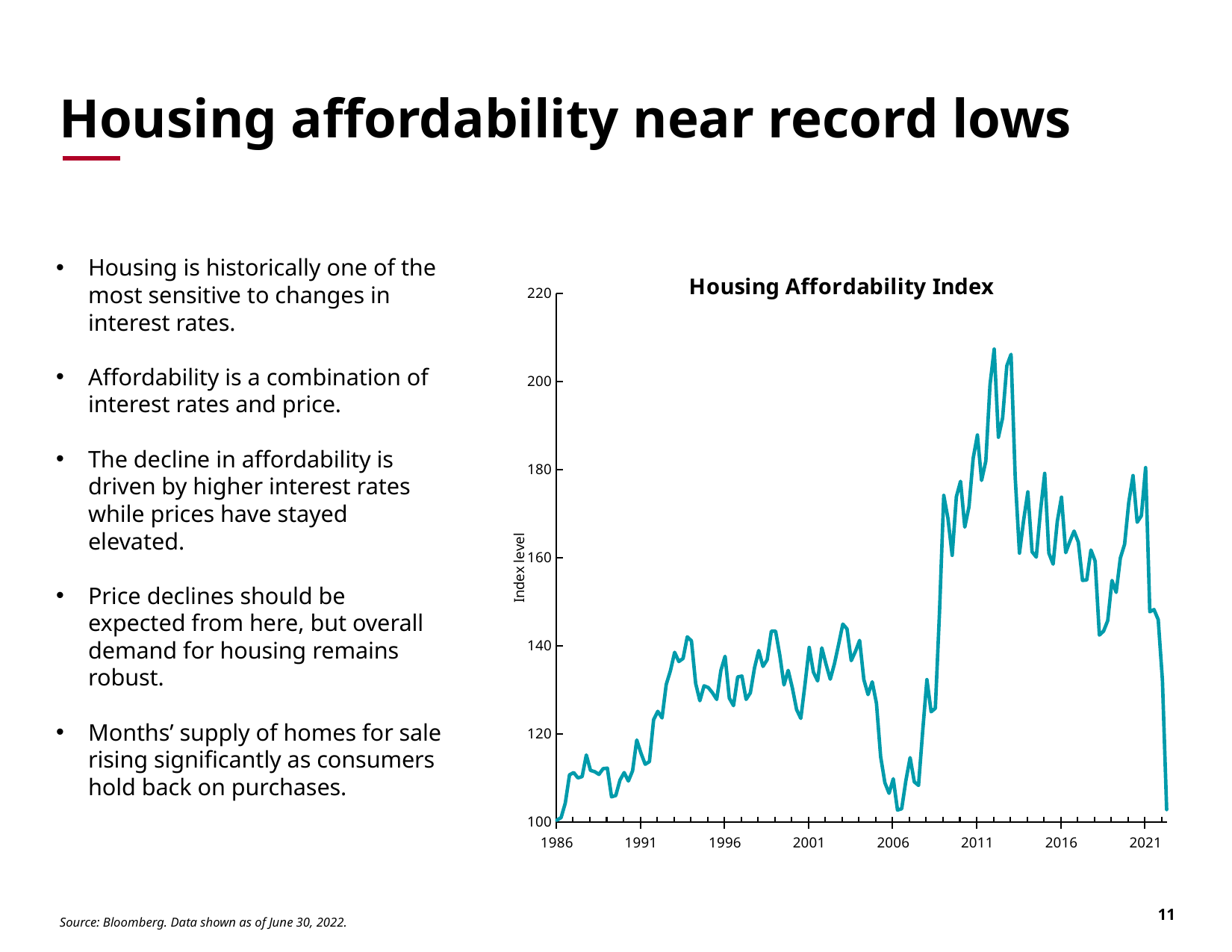
What is the title of the chart? Housing Affordability Index Does the Housing Affordability Index rise or fall between 2013 and 2019? fall Is the value of the Housing Affordability Index in 2001 greater or less than 120? greater Is the value of the Housing Affordability Index in 2006 greater or less than 120? less Is the value of the Housing Affordability Index in 2011 greater or less than 160? greater What kind of chart is shown on the slide? Line chart Does the Housing Affordability Index rise or fall between 2006 and 2011? rise What is the label on the vertical axis of the chart? Index level Does the Housing Affordability Index rise or fall at the far right end of the chart, after 2021? fall How many data series are plotted on the chart? 1